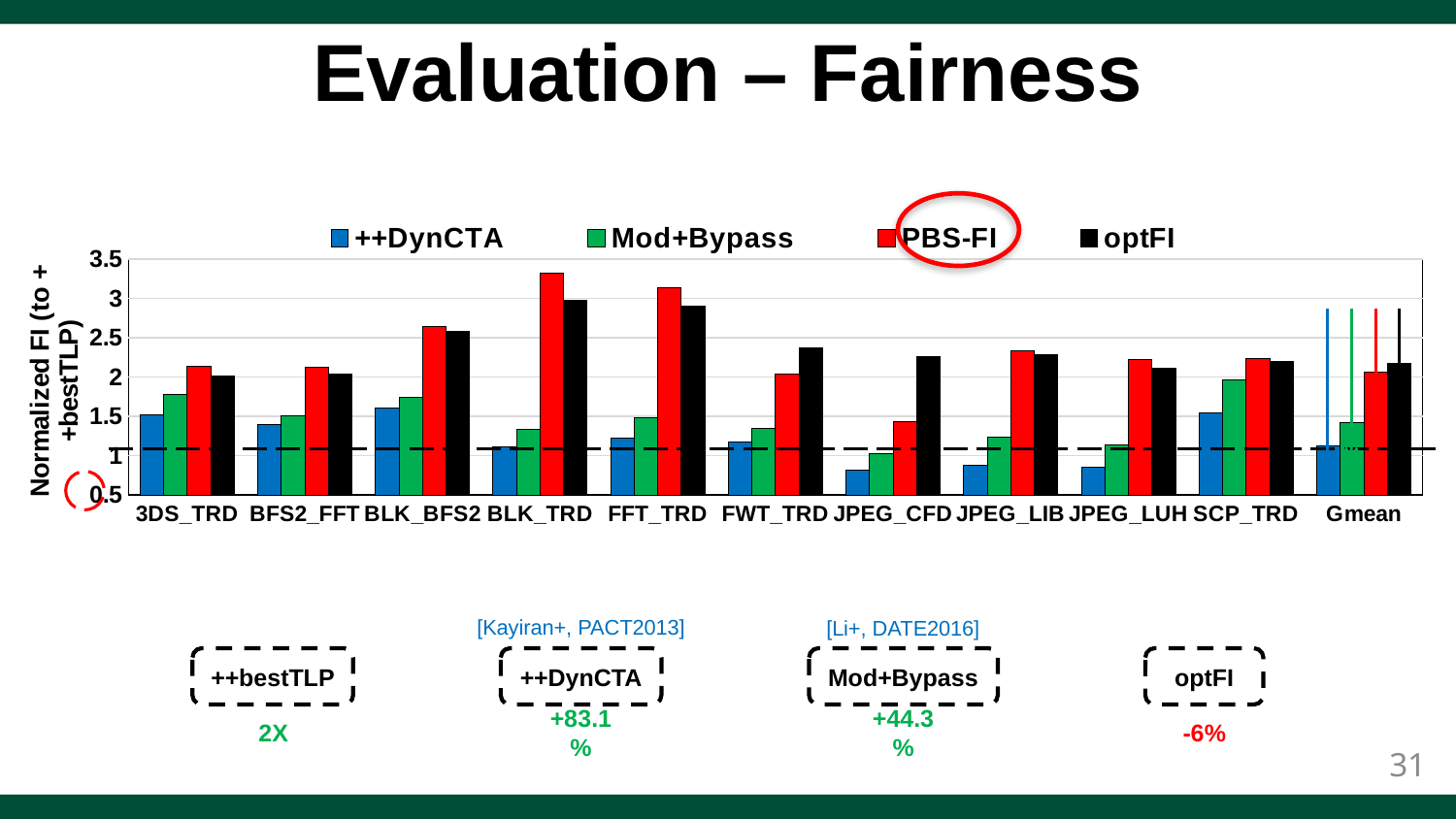
Which series has the lowest value for JPEG_CFD? ++DynCTA For BLK_TRD, which is larger: the PBS-FI value or the ++DynCTA value? PBS-FI What kind of chart is shown on the slide? bar chart How many series does the chart legend list? 4 Which legend entry is circled in red on the chart? PBS-FI Is the PBS-FI value for BLK_TRD greater or less than 3? greater For JPEG_LIB, which is larger: the Mod+Bypass value or the optFI value? optFI Is the optFI value for FWT_TRD greater or less than 2? greater Which category has the highest PBS-FI value? BLK_TRD How many categories are shown along the x axis of the chart? 11 Is the Mod+Bypass value for 3DS_TRD greater or less than 1.5? greater